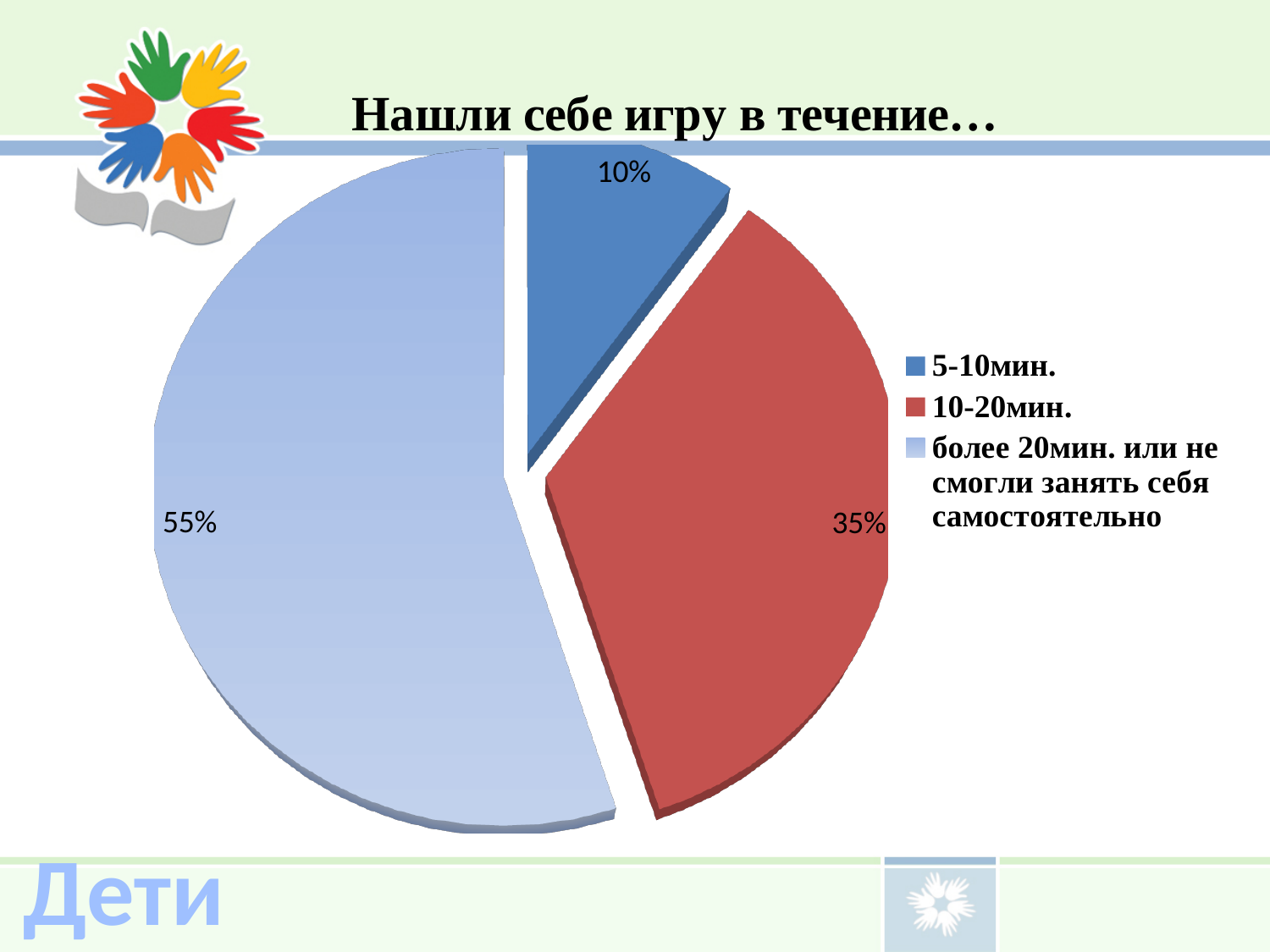
Which category has the smallest slice of the pie? 5-10мин. Which is larger: the "10-20мин." slice or the "5-10мин." slice? 10-20мин. Which category has the largest slice of the pie? более 20мин. или не смогли занять себя самостоятельно What is the difference in percentage points between the "10-20мин." slice and the "5-10мин." slice? 25 What share of the pie does the "более 20мин. или не смогли занять себя самостоятельно" slice have? 55% How many slices does the pie chart have? 3 What is the title of the chart? Нашли себе игру в течение… What share of the pie does the "10-20мин." slice have? 35% What kind of chart is shown on the slide? pie chart What share of the pie does the "5-10мин." slice have? 10% What is the difference in percentage points between the largest slice and the "10-20мин." slice? 20 What colour is the "10-20мин." slice? red